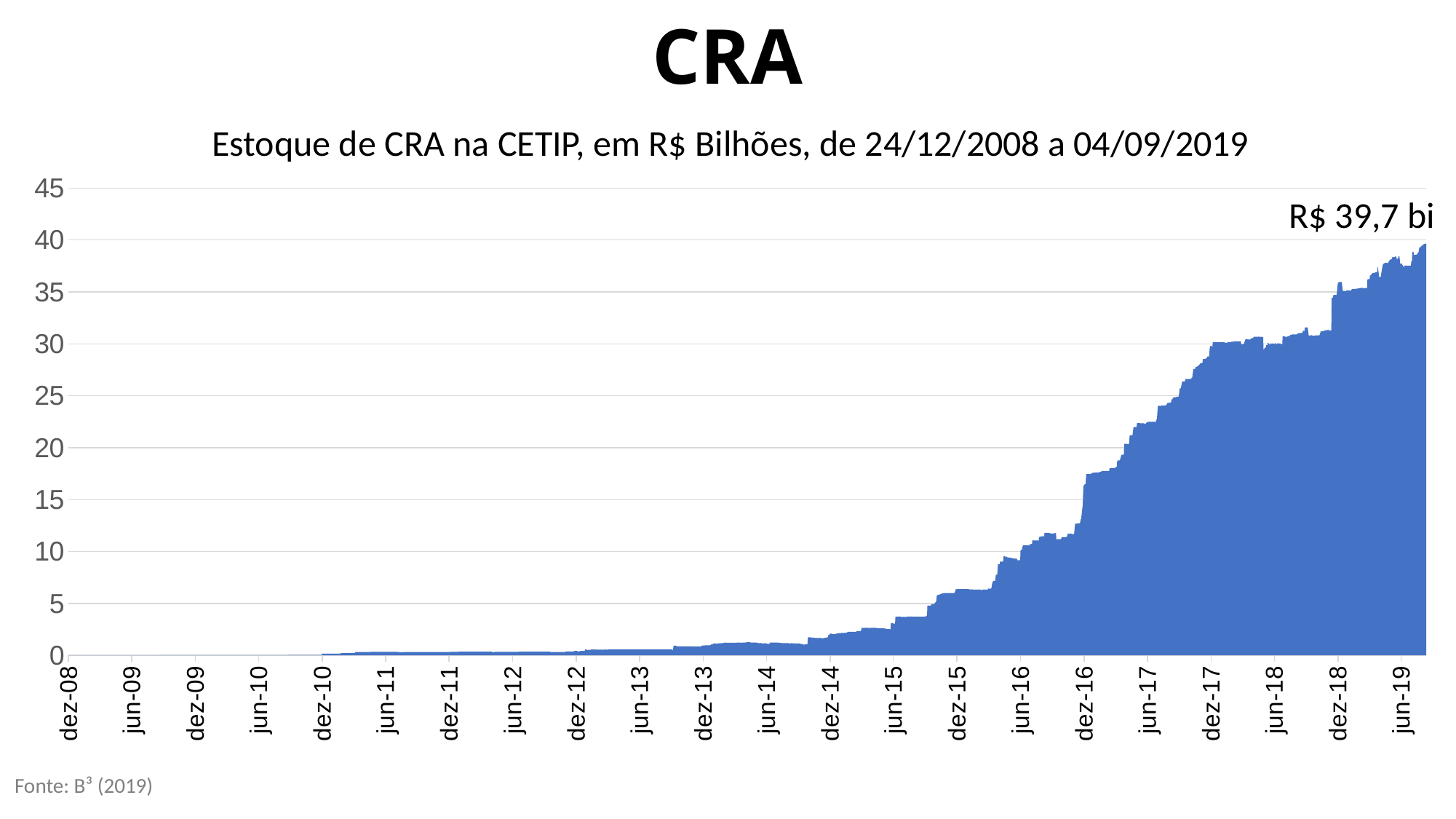
What is the subtitle of the chart? Estoque de CRA na CETIP, em R$ Bilhões, de 24/12/2008 a 04/09/2019 What is the value of the CRA stock at the end of the series, as labelled on the chart? R$ 39,7 bi How many date labels are shown on the x axis? 22 Which of the two is larger: the value at dez-17 or the value at dez-15? dez-17 Is the value at jun-16 greater or less than 15? less Does the CRA stock generally rise or fall from dez-08 to jun-19? Rise Is the value at dez-16 greater or less than 20? less What kind of chart is shown on the slide? Area chart Is the value at dez-15 greater or less than 10? less